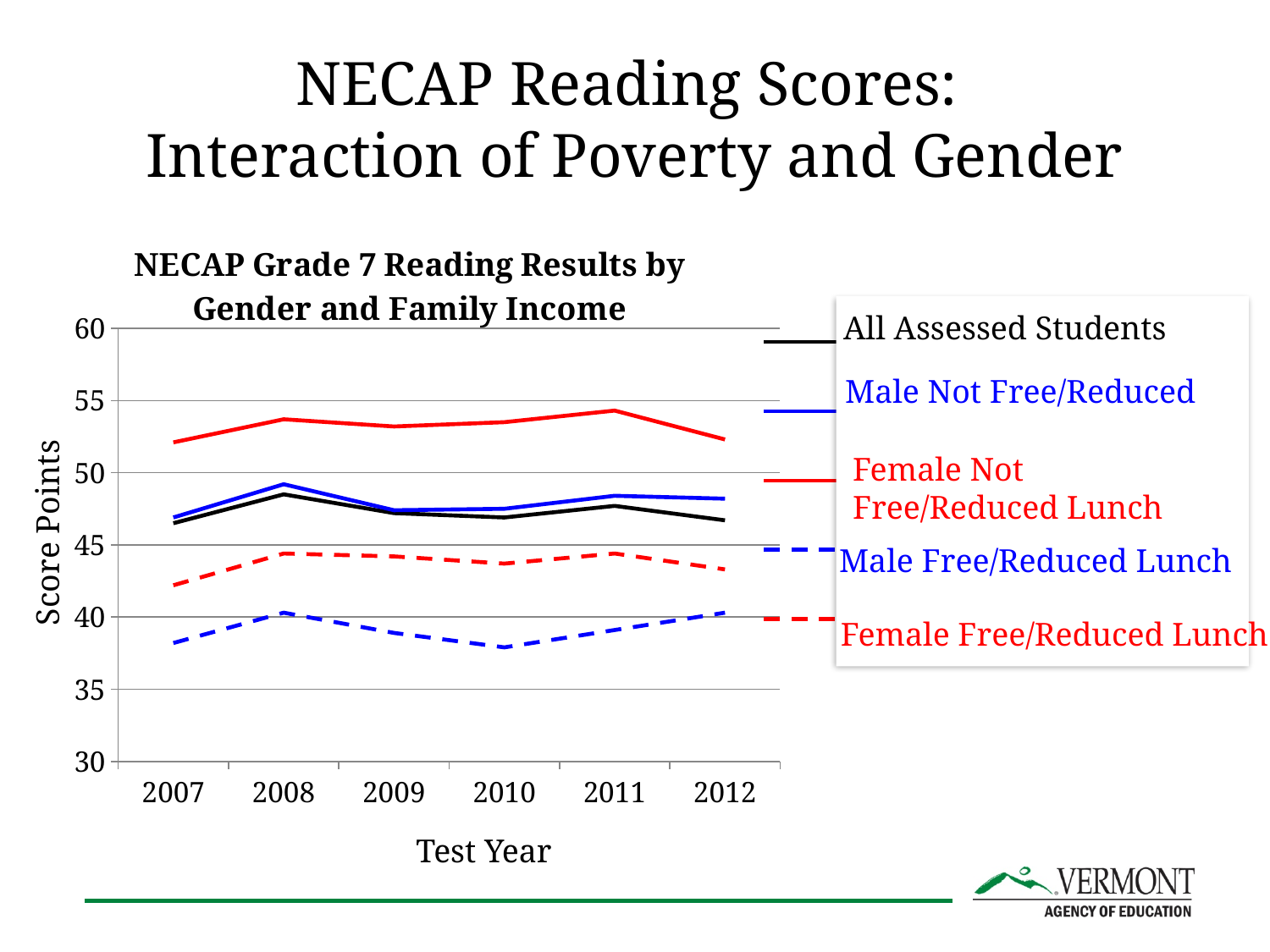
Is the value for Female Free/Reduced Lunch in 2007 greater or less than 45? less In which year does the Female Not Free/Reduced Lunch series reach its highest value? 2011 What kind of chart is shown on the slide? line chart How many test years are plotted on the x axis? 6 Which series has the lowest scores across all years? Male Free/Reduced Lunch In 2008, which is higher: Male Not Free/Reduced or All Assessed Students? Male Not Free/Reduced Which series has the highest scores across all years? Female Not Free/Reduced Lunch What is the title of the y axis? Score Points Is the value for Female Not Free/Reduced Lunch in 2011 greater or less than 50? greater Does the Female Not Free/Reduced Lunch line rise or fall from 2011 to 2012? fall Is the value for Male Free/Reduced Lunch in 2010 greater or less than 40? less How many series does the legend list? 5